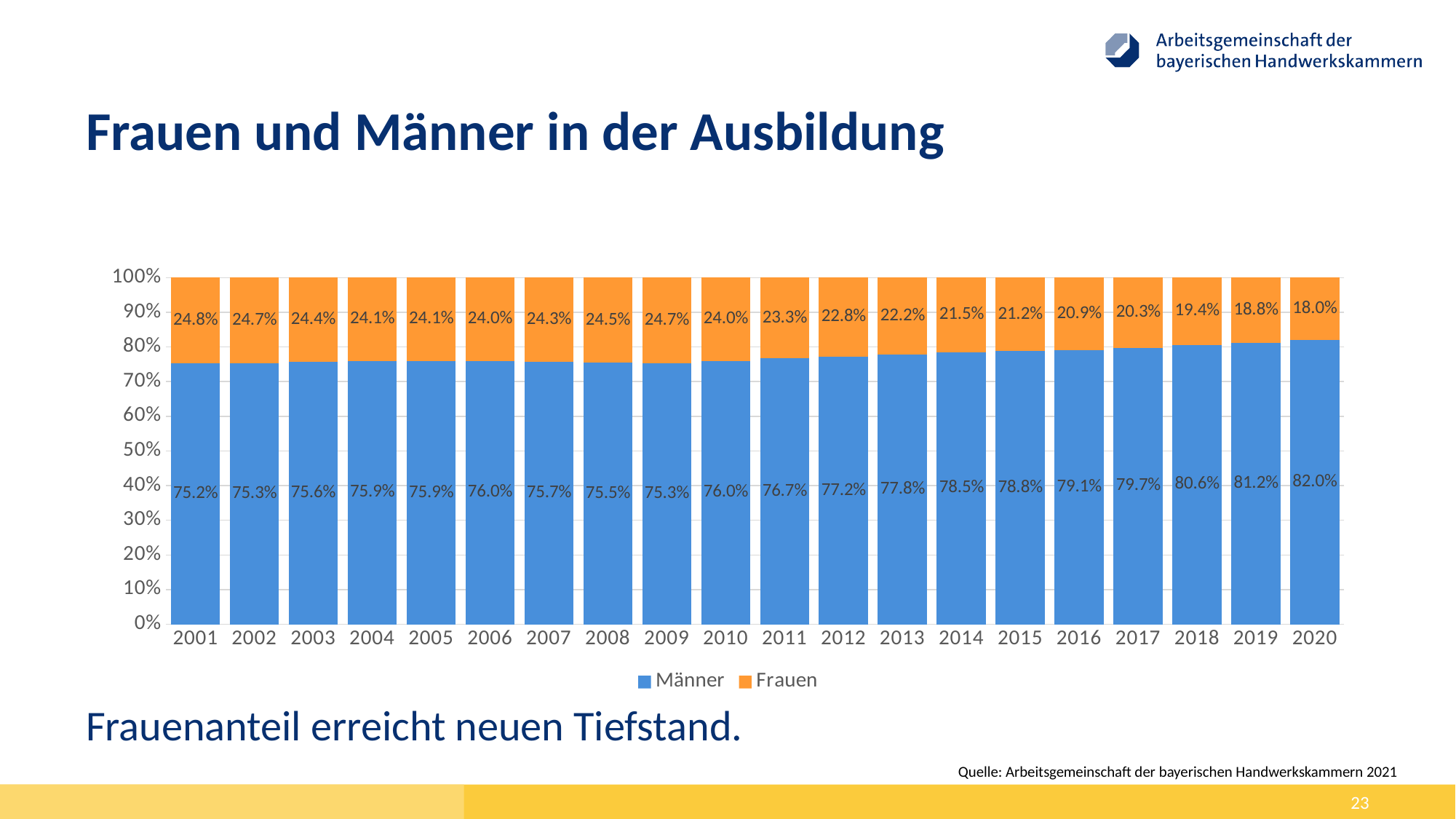
What is the Frauen share in 2020? 18.0% How many series does the legend list? 2 Which is larger, the Männer share in 2010 or in 2015? 2015 In which year is the Frauen share highest? 2001 Which colour represents Frauen in the chart? Orange In which year is the Frauen share lowest? 2020 How many years are shown on the x axis? 20 Does the Frauen share rise or fall from 2010 to 2020? Fall What is the difference between the Frauen share in 2001 and in 2020? 6.8 percentage points What kind of chart is shown? Stacked bar chart What is the Männer share in 2001? 75.2% What is the Frauen share in 2011? 23.3%